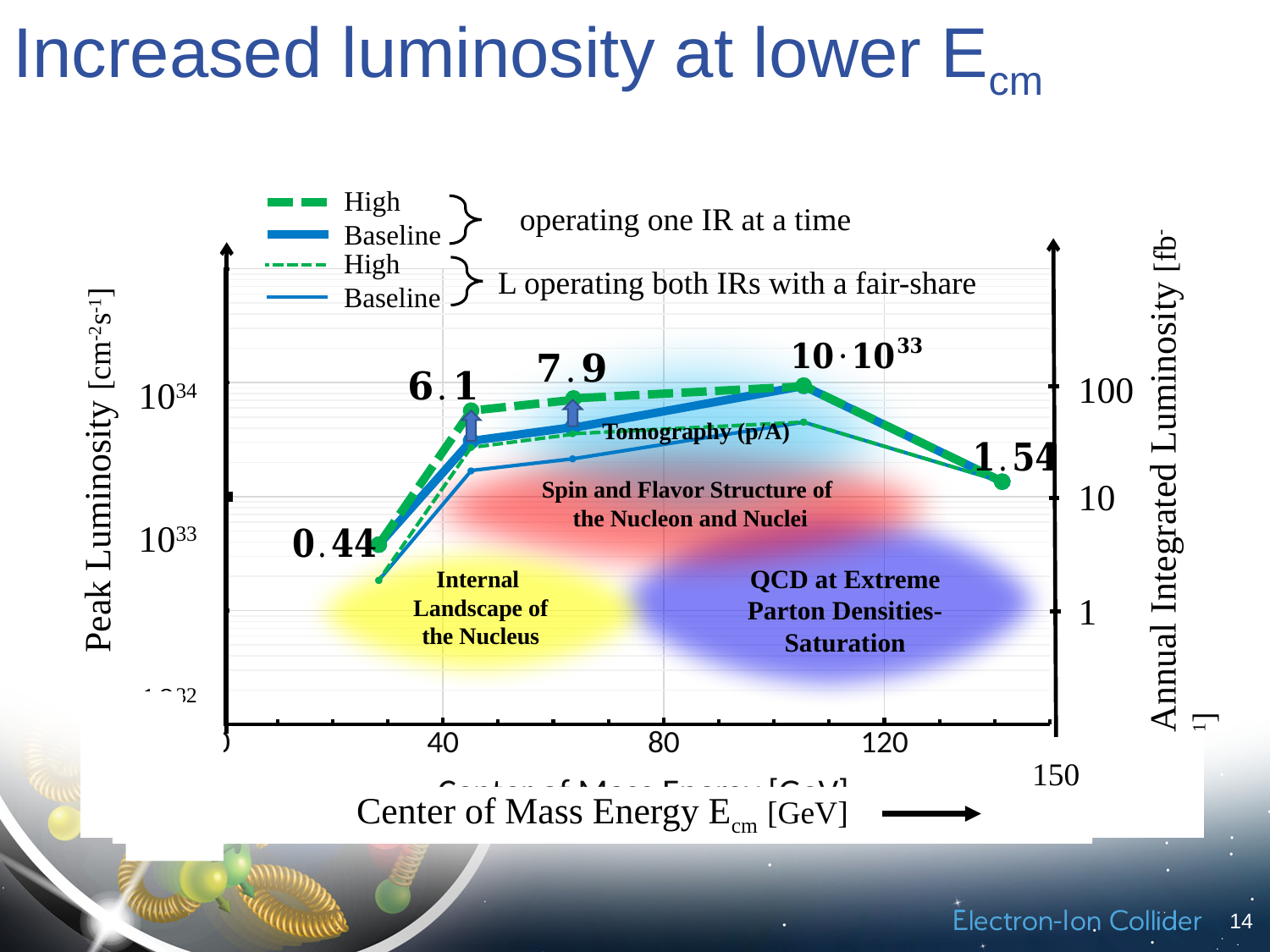
Is the peak luminosity at the rightmost data point (near 140 GeV) greater or less than 10^34? less How many data points on the chart have printed data labels? 5 What data label is printed at the rightmost data point of the chart (near 140 GeV)? 1.54 What is the largest data label value printed on the chart? 10·10^33 What data label is printed at the leftmost data point of the chart (near 30 GeV)? 0.44 What is the label of the x axis of the chart? Center of Mass Energy Ecm [GeV] What is the smallest data label value printed on the chart? 0.44 Do the plotted luminosity values rise or fall as the center of mass energy increases from 40 GeV to about 100 GeV? rise How many series does the chart legend list? 4 Which is larger, the data label 6.1 or the data label 7.9? 7.9 What is the difference between the data labels 7.9 and 6.1? 1.8 What kind of chart is shown on the slide? line chart